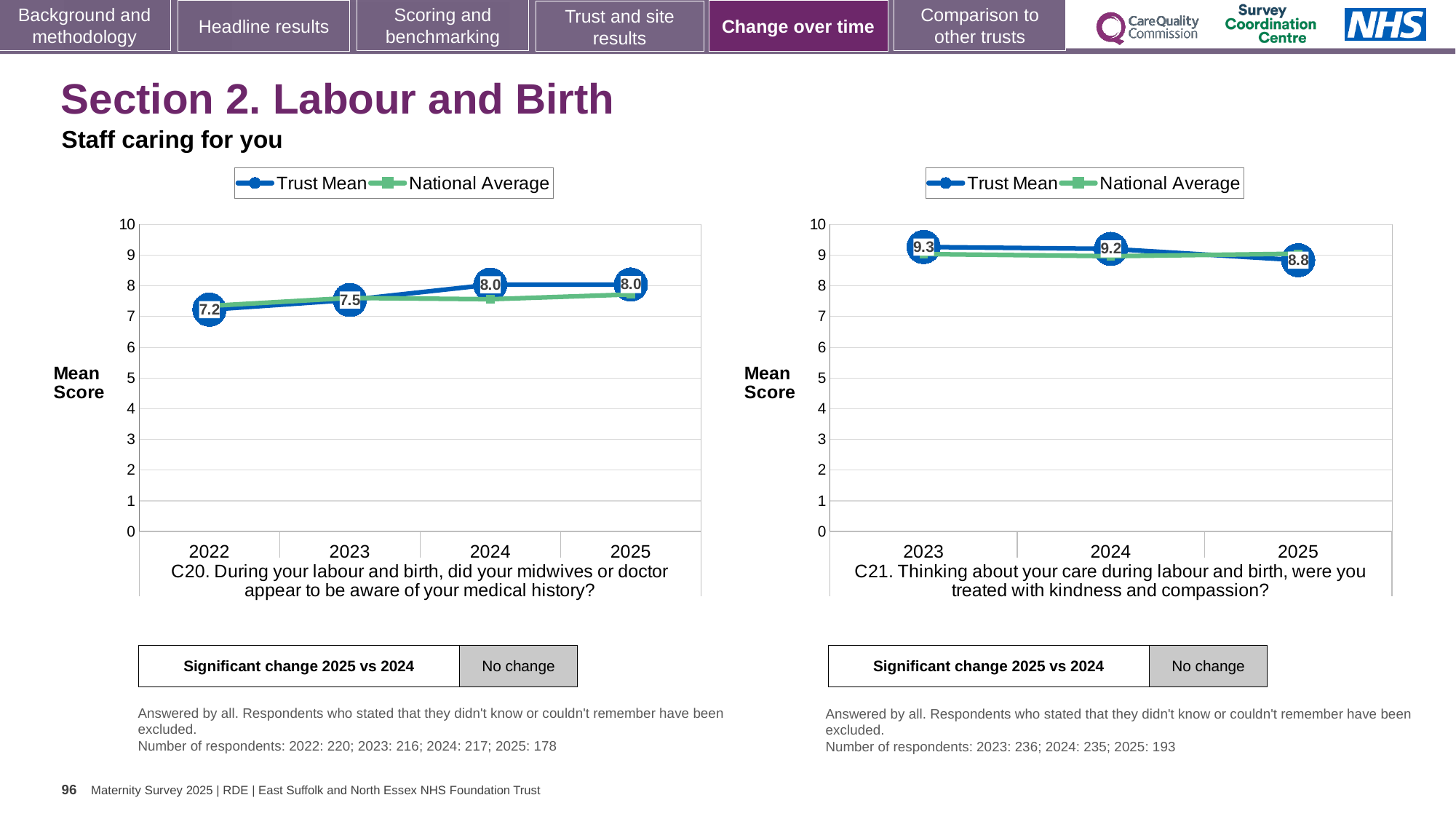
In the C20 chart on the left, which year has the lowest Trust Mean? 2022 In the C20 chart on the left, what is the Trust Mean for 2022? 7.2 How many series does the legend of the C20 chart on the left list? 2 How many years are shown on the x axis of the C21 chart on the right? 3 In the C21 chart on the right, what is the Trust Mean for 2024? 9.2 In the C20 chart on the left, is the National Average for 2022 greater or less than 8? less In the C21 chart on the right, does the Trust Mean rise or fall from 2023 to 2025? fall In the C21 chart on the right, what is the difference between the Trust Mean in 2023 and in 2025? 0.5 In the C21 chart on the right, which year has the highest Trust Mean? 2023 In the C20 chart on the left, is the Trust Mean higher in 2023 or in 2025? 2025 In the C20 chart on the left, what is the Trust Mean for 2025? 8.0 In the C20 chart on the left, what is the difference between the Trust Mean in 2025 and in 2022? 0.8